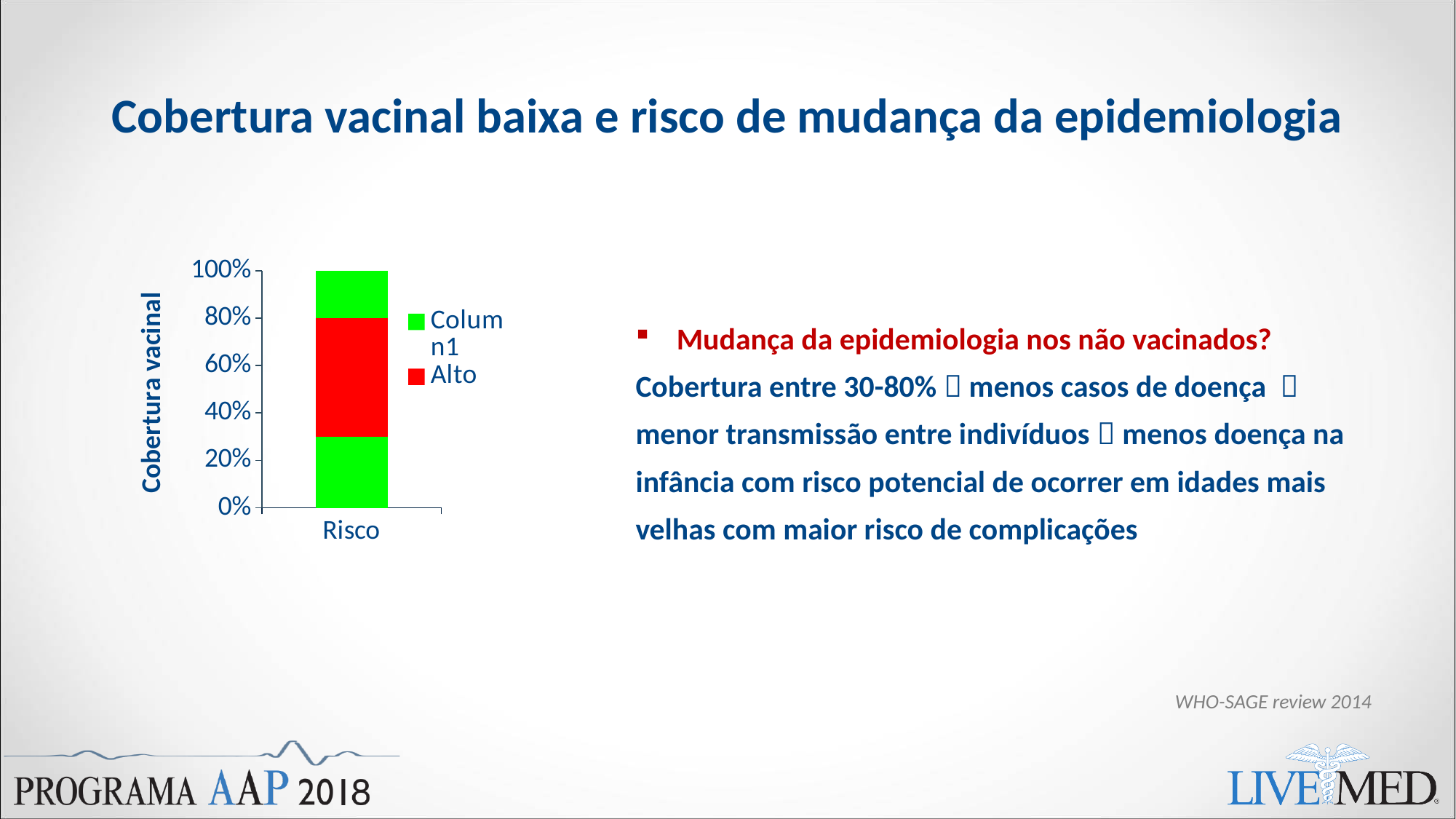
Which segment of the bar is taller, the red 'Alto' segment or the green segment above it? the red 'Alto' segment At what value on the vertical axis does the red 'Alto' segment of the bar end at its top? 80% What value does the top of the stacked bar for Risco reach on the vertical axis? 100% Is the top of the lower green segment of the bar greater or less than 20%? greater What kind of chart is shown on the slide? bar chart What are the two entries in the chart's legend? Column1 and Alto Is the upper boundary of the red 'Alto' segment greater or less than 60%? greater What is the title of the chart's vertical axis? Cobertura vacinal Is the lower boundary of the red 'Alto' segment greater or less than 40%? less How many series does the chart's legend list? 2 Which segment of the bar is taller, the red 'Alto' segment or the green segment below it? the red 'Alto' segment How many categories are shown on the x axis of the chart? 1